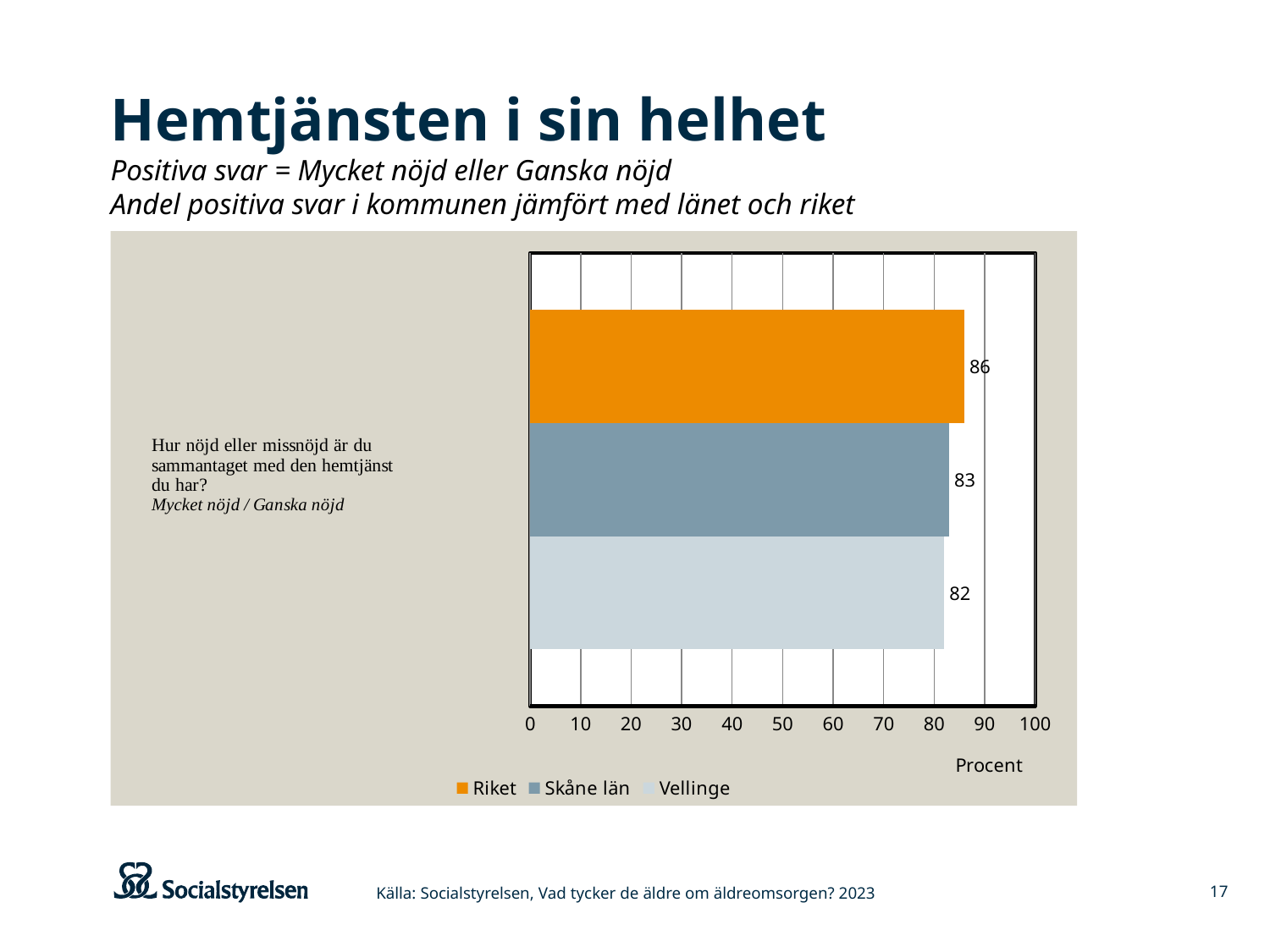
What is the value for Vellinge? 82 What is the difference between the values for Skåne län and Vellinge? 1 What is the value for Skåne län? 83 Is the value for Vellinge greater or less than 90? less Which series has the highest value? Riket What is the difference between the values for Riket and Vellinge? 4 What is the label on the horizontal axis of the chart? Procent How many series does the legend list? 3 Which series has the lowest value? Vellinge What is the value for Riket? 86 What kind of chart is shown on the slide? bar chart Which is larger, the value for Riket or the value for Skåne län? Riket